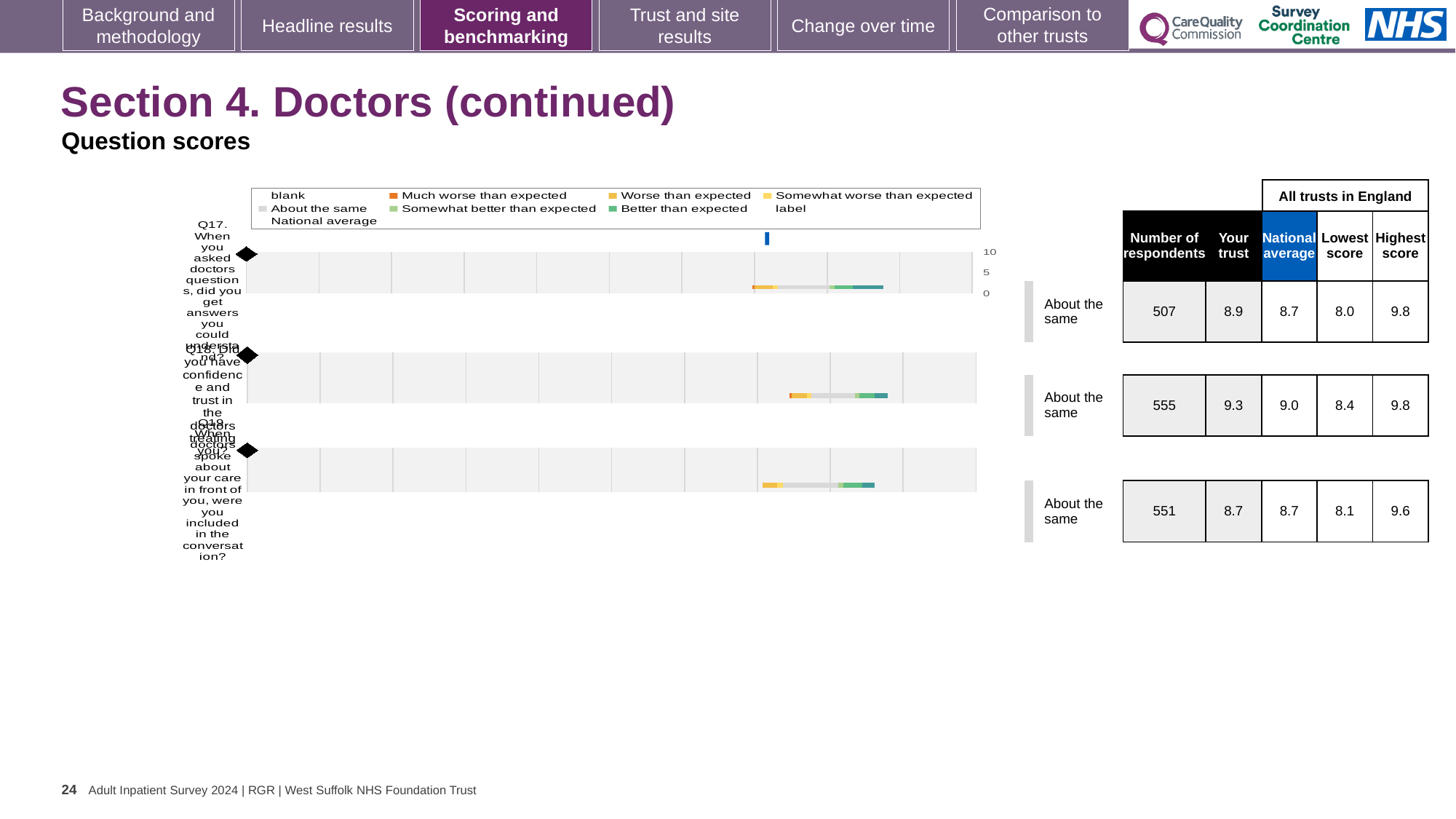
What is the lowest score among all trusts in England for Q17? 8.0 What is the 'Your trust' score for Q17 (getting answers you could understand from doctors)? 8.9 For Q17, which is larger: the 'Your trust' score or the national average? Your trust How many respondents answered Q18 (confidence and trust in doctors)? 555 What benchmark category is shown for Q19 (doctors speaking about your care in front of you)? About the same Which question has the highest 'Your trust' score? Q18 Which question has the lowest 'Your trust' score? Q19 Is the 'Your trust' score for Q18 greater or less than 5 on the chart axis? greater For Q18, how much higher is the 'Your trust' score than the national average? 0.3 What is the highest score among all trusts in England for Q19? 9.6 What kind of chart is used to show the question scores for Q17 to Q19? bar chart How many questions (categories) are plotted in the chart? 3